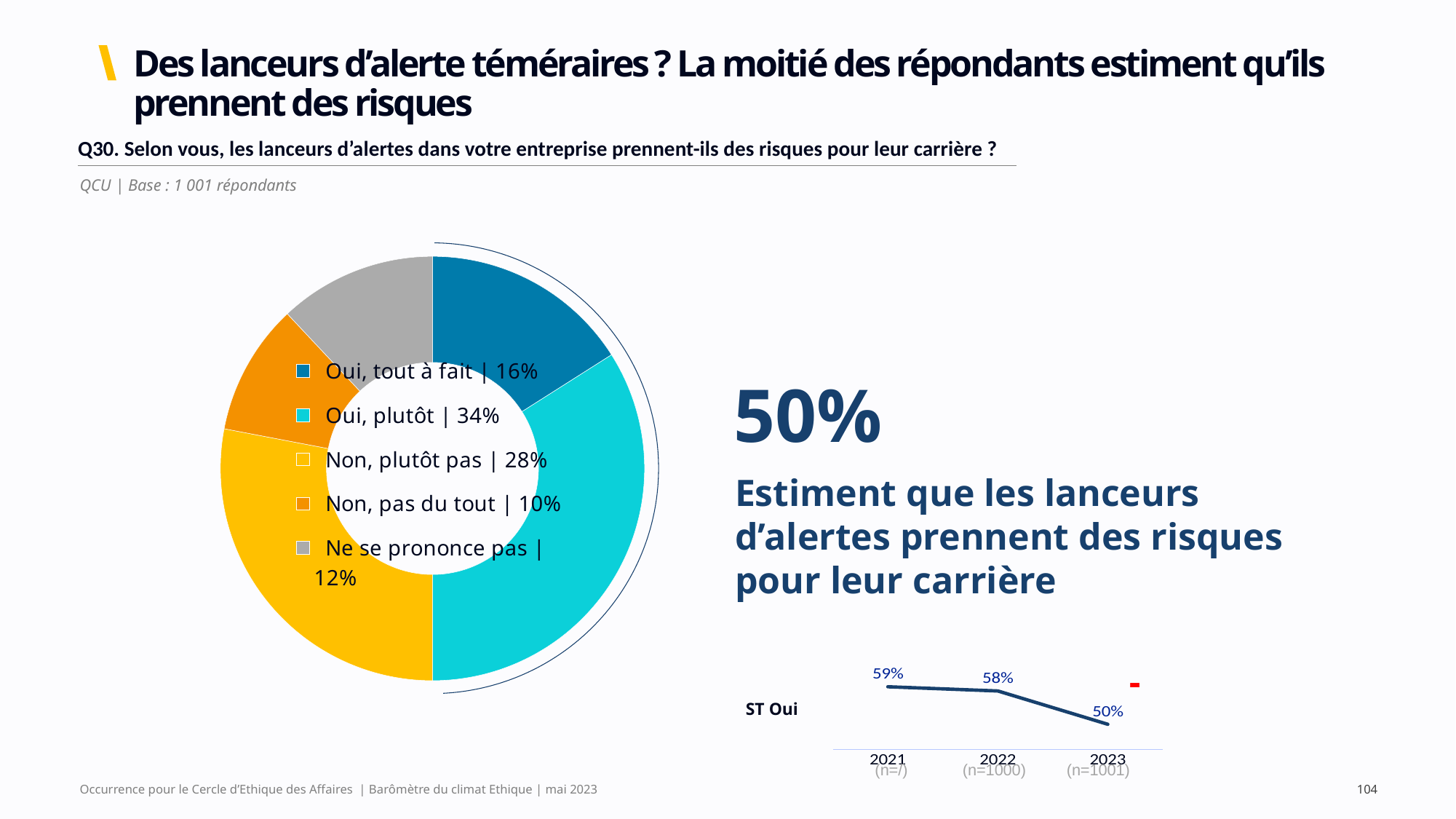
On the donut chart on the left, what is the difference between "Oui, plutôt" and "Non, plutôt pas"? 6% How many categories does the donut chart on the left show? 5 On the donut chart on the left, which category has the highest value? Oui, plutôt On the donut chart on the left, what is the value for "Oui, plutôt"? 34% On the "ST Oui" line chart at the bottom right, what is the value for 2022? 58% On the "ST Oui" line chart at the bottom right, what is the difference between the 2021 and 2023 values? 9% On the donut chart on the left, which category has the lowest value? Non, pas du tout What kind of chart is the chart on the left of the slide? Donut (pie) chart On the donut chart on the left, what is the value for "Non, pas du tout"? 10% On the donut chart on the left, what colour is the "Non, plutôt pas" segment? Yellow On the "ST Oui" line chart at the bottom right, do the values rise or fall from 2021 to 2023? Fall On the donut chart on the left, which is larger: "Oui, tout à fait" or "Ne se prononce pas"? Oui, tout à fait